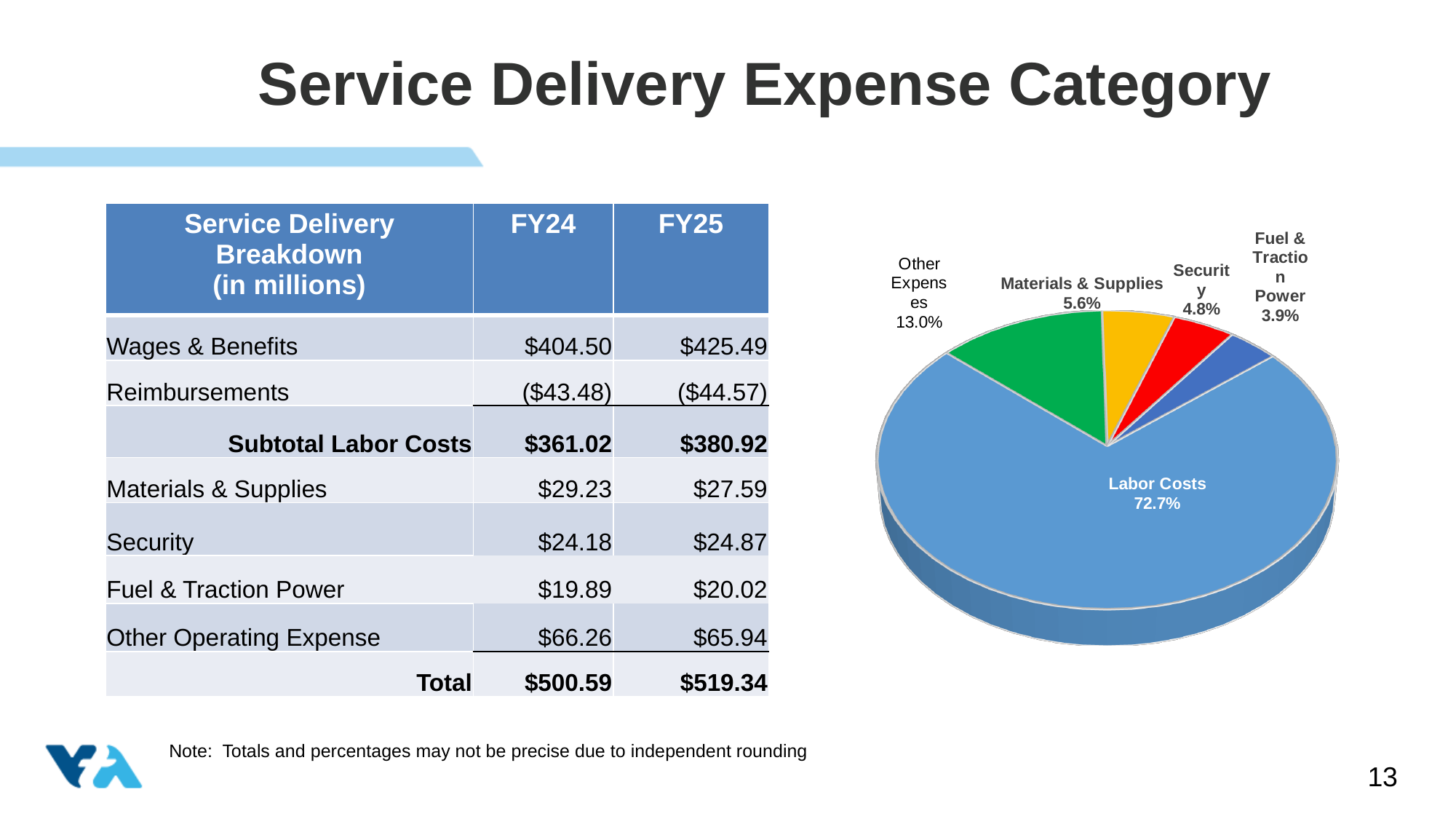
What percentage is shown for Other Expenses in the pie chart? 13.0% What percentage is shown for Materials & Supplies in the pie chart? 5.6% What percentage is shown for Fuel & Traction Power in the pie chart? 3.9% How many slices does the pie chart have? 5 What type of chart is shown on the right side of the slide? Pie chart What percentage is shown for Security in the pie chart? 4.8% What colour is the Labor Costs slice in the pie chart? Blue Which category has the smallest slice in the pie chart? Fuel & Traction Power In the pie chart, which is larger: Other Expenses or Materials & Supplies? Other Expenses What share of the pie chart does Labor Costs represent? 72.7% What is the difference in percentage points between Labor Costs and Other Expenses in the pie chart? 59.7 Which category has the largest slice in the pie chart? Labor Costs